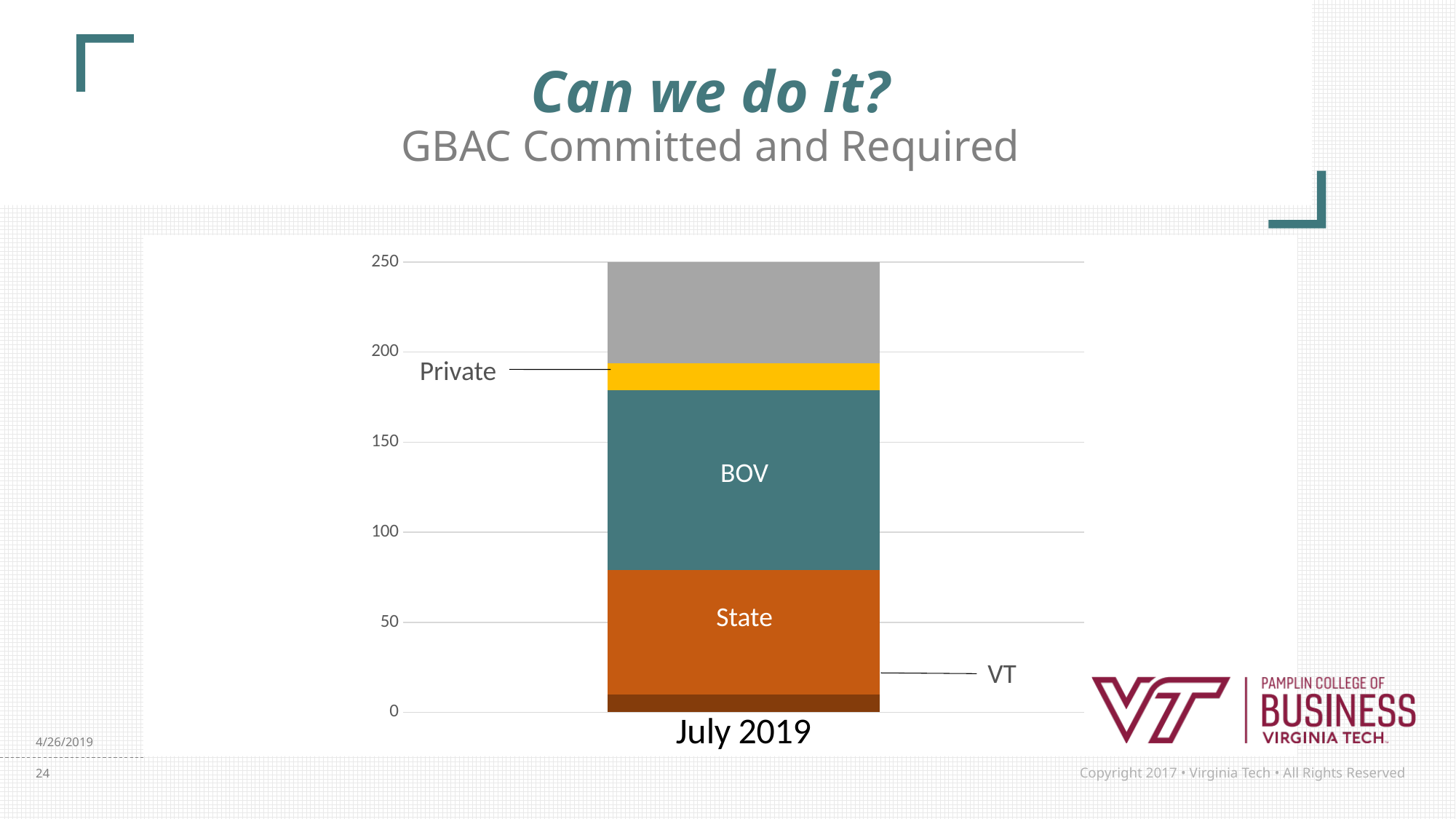
Is the cumulative value at the top of the BOV segment greater or less than 150? greater How many categories are shown on the x axis of the chart? 1 What is the total height of the stacked bar for July 2019? 250 Which labeled segment of the stacked bar is the smallest? VT What is the title text shown above the chart? Can we do it? GBAC Committed and Required Which segment is larger, BOV or State? BOV Which labeled segment of the stacked bar is the largest? BOV What is the category label on the x axis of the chart? July 2019 Is the cumulative value at the top of the State segment greater or less than 50? greater Is the cumulative value at the top of the Private segment greater or less than 200? less What kind of chart is shown on the slide? Stacked bar chart Which segment is larger, State or Private? State